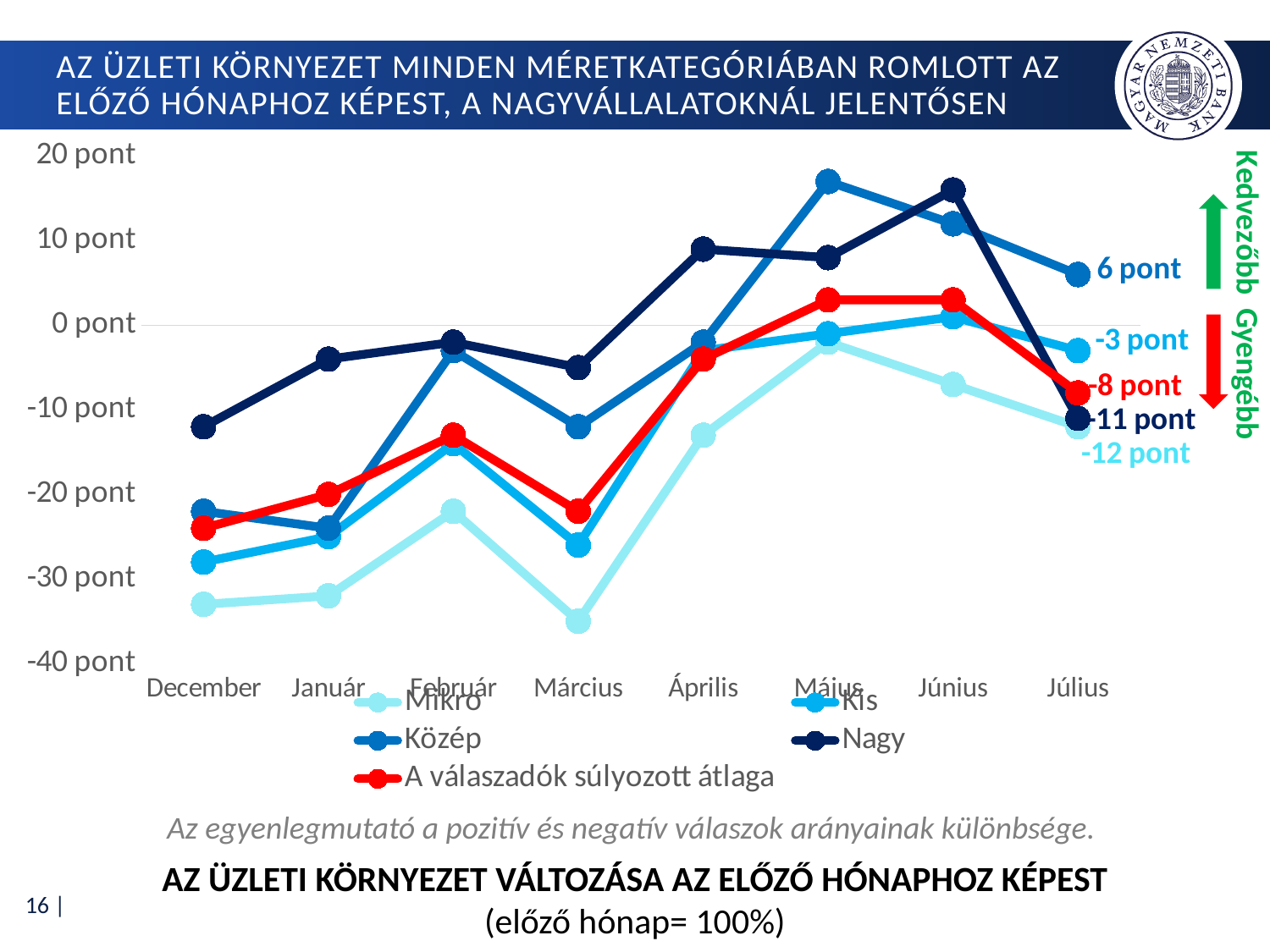
Which series has the lowest value in Július? Mikró What is the value for Kis in Július? -3 pont What is the value for Közép in Július? 6 pont Which series has the highest value in Július? Közép What is the value for Mikró in Július? -12 pont What is the difference between the Közép and Kis values in Július? 9 pont How many series does the legend list? 5 What is the value for Nagy in Július? -11 pont How many months are shown on the x axis? 8 Is the value for Mikró in Március greater or less than -30 pont? less What kind of chart is shown on the slide? line chart What is the value for 'A válaszadók súlyozott átlaga' in Július? -8 pont